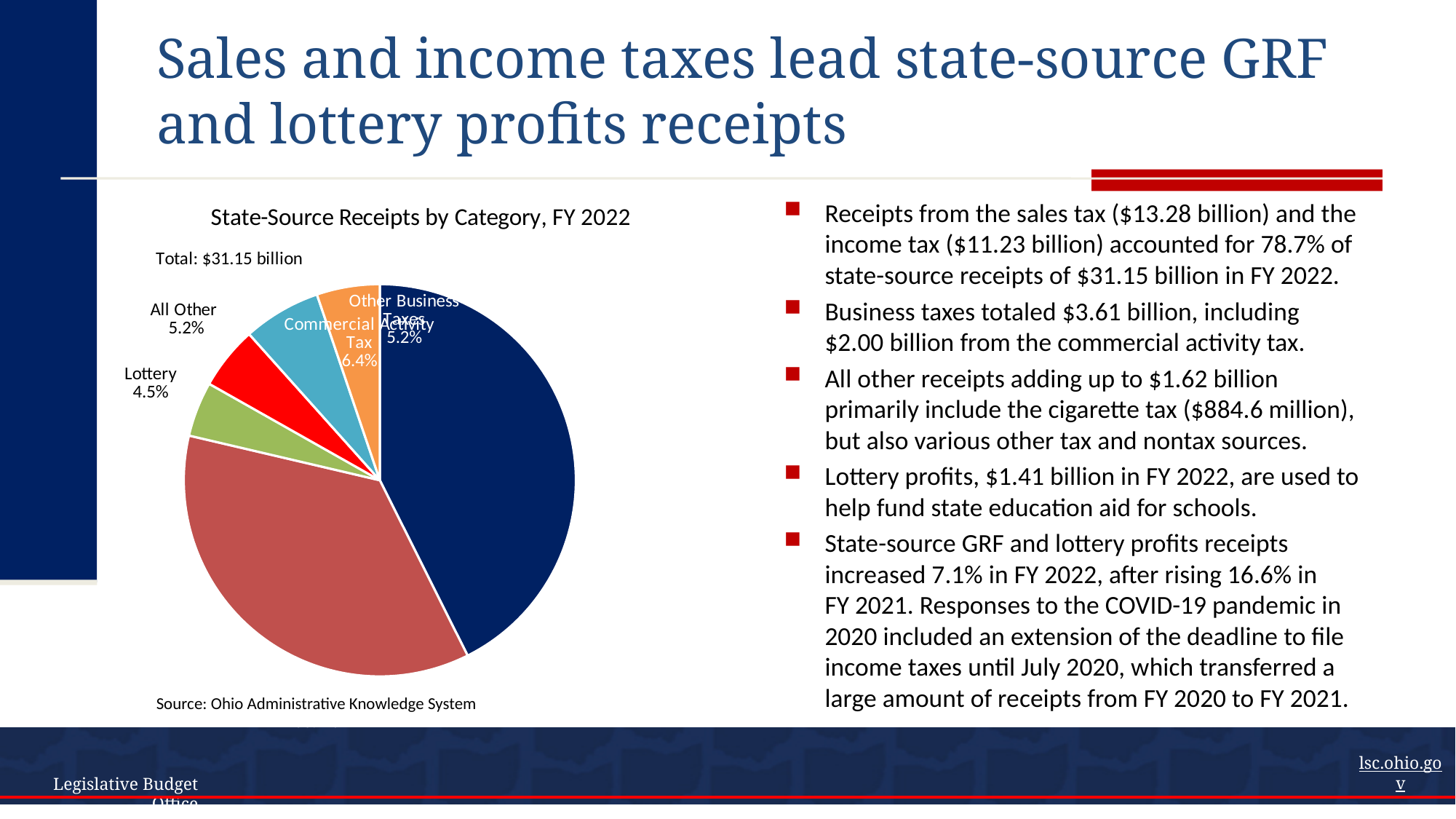
How many slices does the pie chart have? 6 What type of chart is shown on the slide? Pie chart What share of state-source receipts does Lottery account for in the pie chart? 4.5% Which is larger in the pie chart, the Commercial Activity Tax share or the Lottery share? Commercial Activity Tax What source is cited below the pie chart? Ohio Administrative Knowledge System What share of state-source receipts do Other Business Taxes account for in the pie chart? 5.2% What share of state-source receipts does the Commercial Activity Tax account for in the pie chart? 6.4% Which labeled category has the smallest slice in the pie chart? Lottery What total amount is shown above the pie chart? $31.15 billion What is the difference in percentage points between the Commercial Activity Tax share and the Lottery share? 1.9 percentage points What is the title of the chart? State-Source Receipts by Category, FY 2022